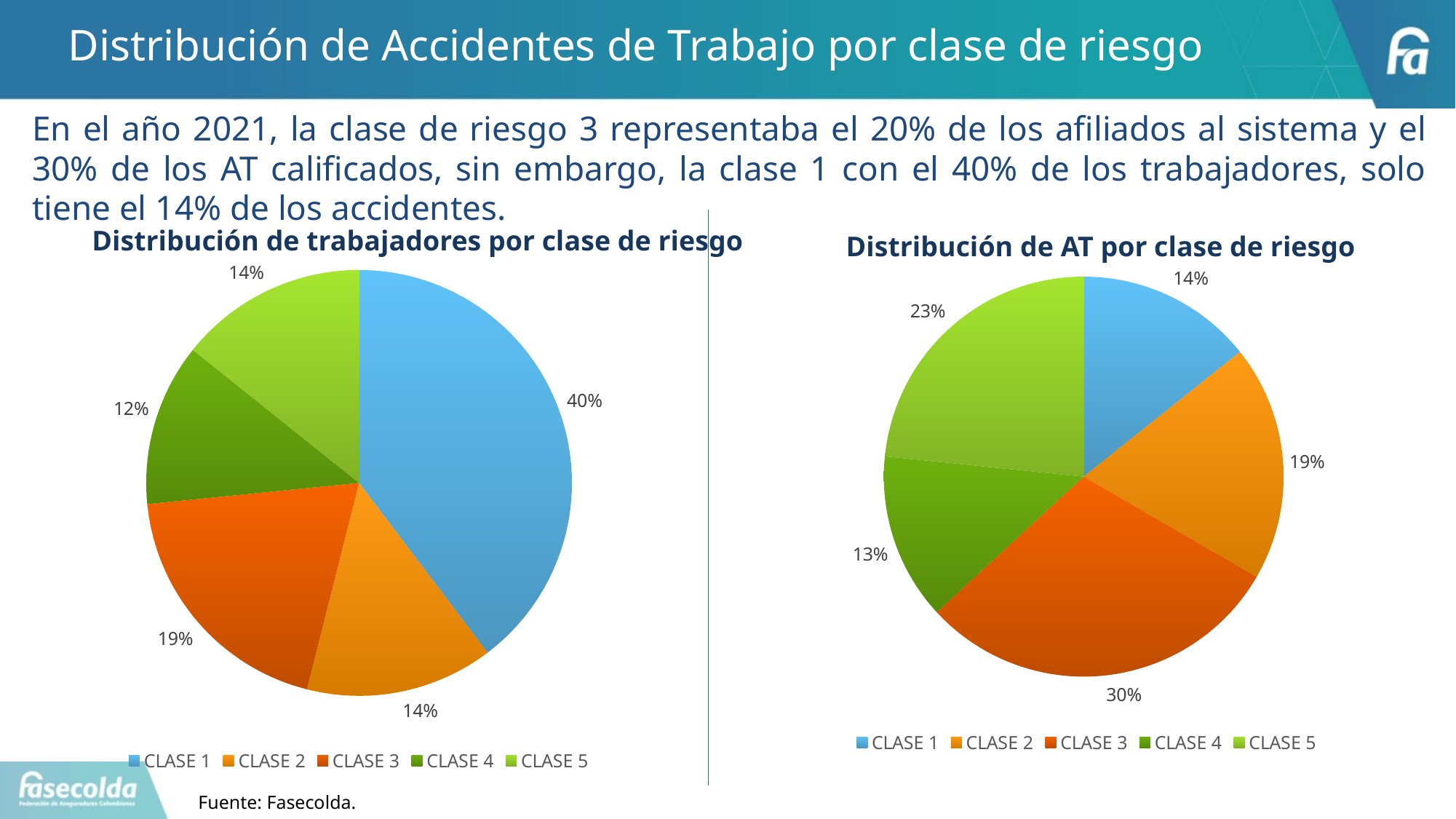
In the chart 'Distribución de trabajadores por clase de riesgo', what share does CLASE 4 have? 12% In the chart 'Distribución de AT por clase de riesgo', which is larger, the share of CLASE 2 or the share of CLASE 5? CLASE 5 In the chart 'Distribución de trabajadores por clase de riesgo', what share does CLASE 1 have? 40% How many slices does the chart 'Distribución de AT por clase de riesgo' have? 5 In the chart 'Distribución de AT por clase de riesgo', what share does CLASE 5 have? 23% In the chart 'Distribución de AT por clase de riesgo', what share does CLASE 3 have? 30% In the chart 'Distribución de trabajadores por clase de riesgo', what is the difference between the shares of CLASE 1 and CLASE 3? 21% What type of chart is 'Distribución de trabajadores por clase de riesgo'? Pie chart In the chart 'Distribución de trabajadores por clase de riesgo', which colour represents CLASE 3? Dark orange In the chart 'Distribución de trabajadores por clase de riesgo', which class has the smallest share? CLASE 4 In the chart 'Distribución de AT por clase de riesgo', which class has the largest share? CLASE 3 In the chart 'Distribución de AT por clase de riesgo', which class has the smallest share? CLASE 4